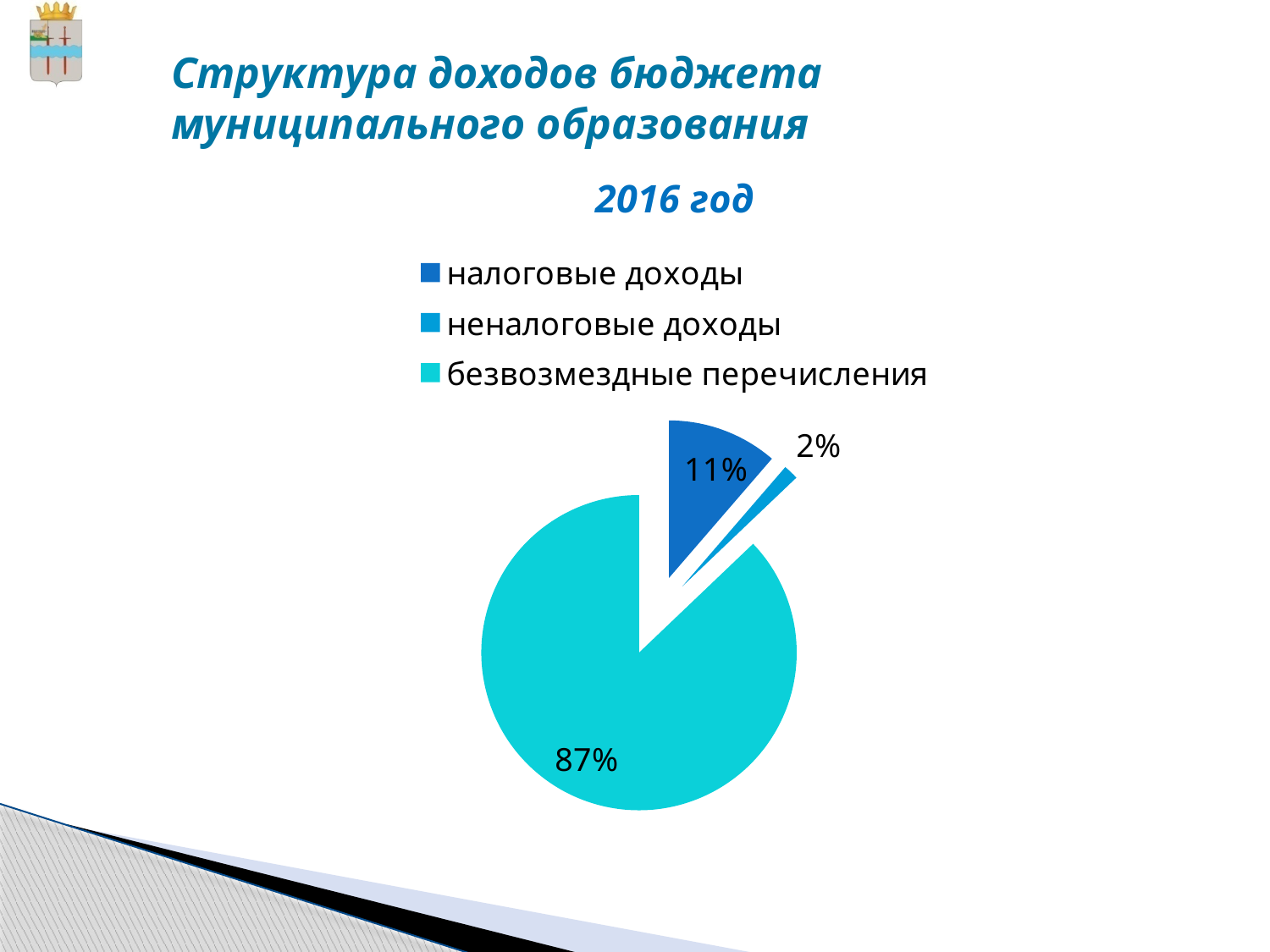
What share of the pie does 'неналоговые доходы' have? 2% Which category has the largest slice of the pie? безвозмездные перечисления What kind of chart is shown on the slide? pie chart What share of the pie does 'налоговые доходы' have? 11% What is the combined share of 'налоговые доходы' and 'неналоговые доходы'? 13% What year is shown in the chart title? 2016 год Which category has the smallest slice of the pie? неналоговые доходы How many slices does the pie chart have? 3 Which is larger: 'налоговые доходы' or 'неналоговые доходы'? налоговые доходы What is the difference in percentage points between 'безвозмездные перечисления' and 'налоговые доходы'? 76 What share of the pie does 'безвозмездные перечисления' have? 87% How many entries does the legend list? 3